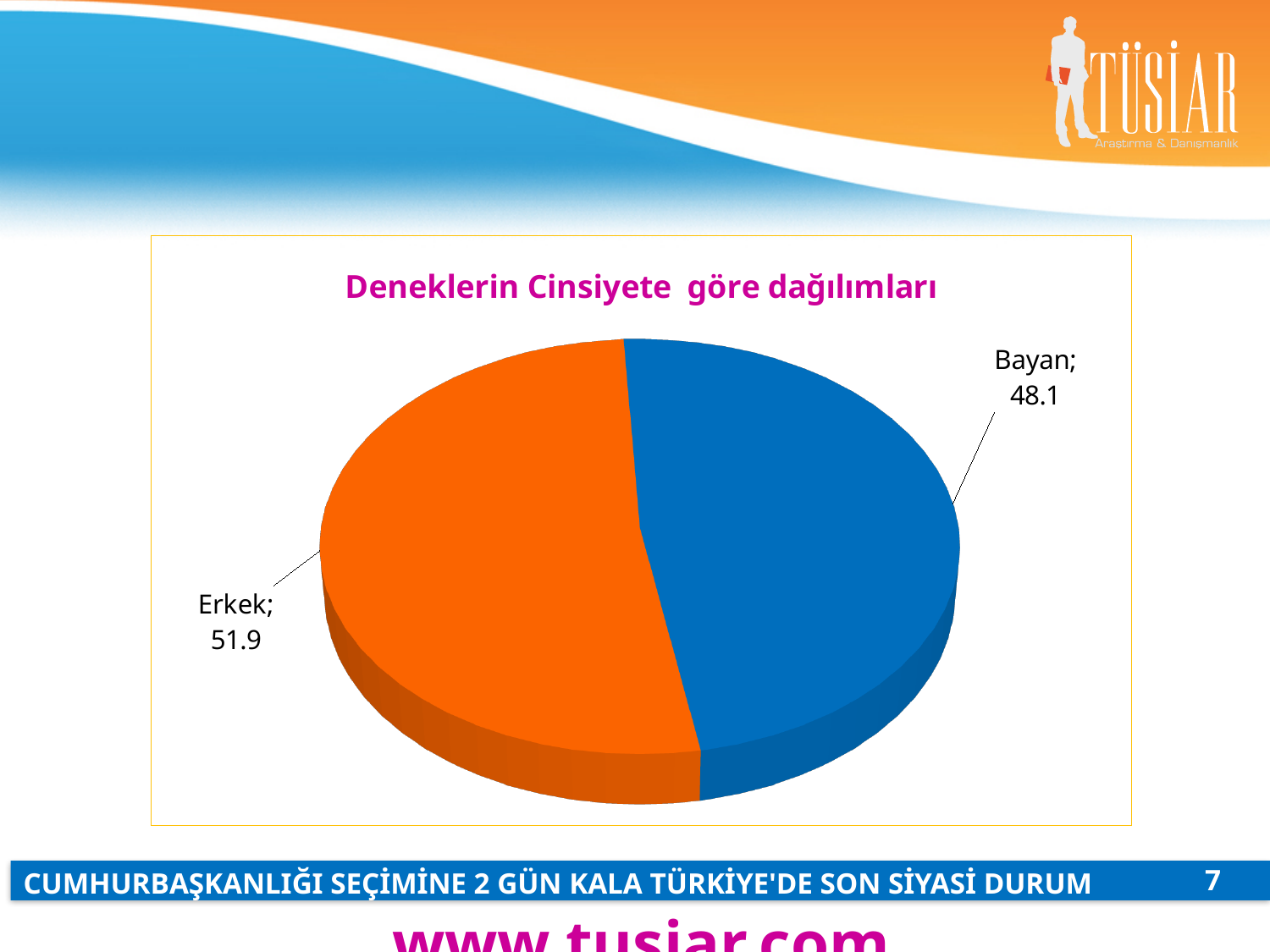
What is the title of the chart? Deneklerin Cinsiyete göre dağılımları What is the value for Erkek? 51.9 Which category has the smallest slice? Bayan Which is larger, the value for Erkek or the value for Bayan? Erkek How many slices does the pie chart have? 2 What is the total of the two slice values? 100 What is the value for Bayan? 48.1 Which category has the largest slice? Erkek What colour is the Erkek slice? orange What kind of chart is shown on the slide? pie chart What is the difference between the values for Erkek and Bayan? 3.8